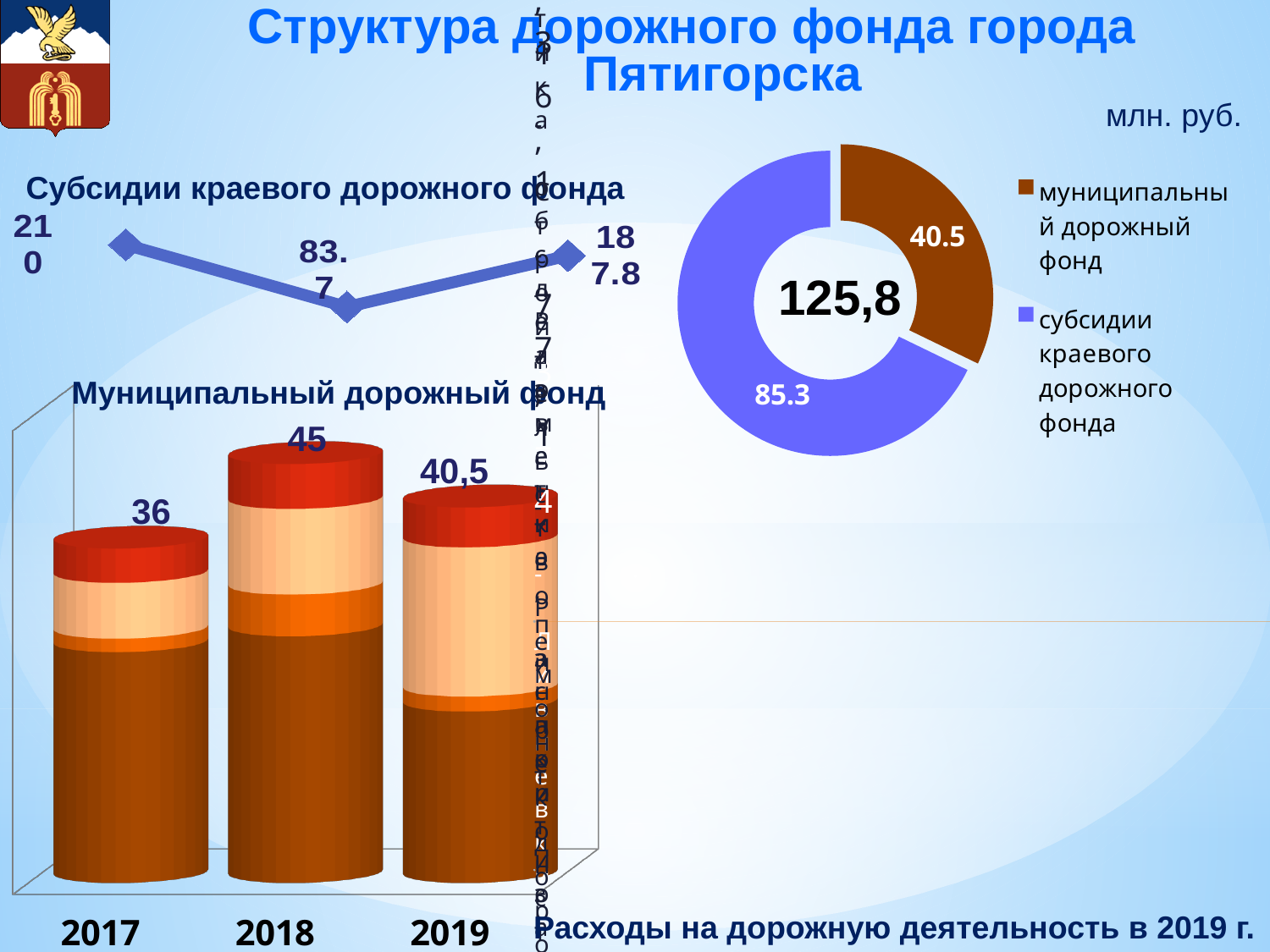
In the doughnut chart on the right, which category is larger: 'муниципальный дорожный фонд' or 'субсидии краевого дорожного фонда'? субсидии краевого дорожного фонда What total is printed in the centre of the doughnut chart on the right? 125,8 In the chart 'Муниципальный дорожный фонд', how many years are shown? 3 What kind of chart is 'Муниципальный дорожный фонд'? bar chart In the chart 'Муниципальный дорожный фонд', which year has the lowest value? 2017 In the chart 'Муниципальный дорожный фонд', what is the value for 2019? 40,5 How many entries does the legend of the doughnut chart on the right list? 2 In the doughnut chart on the right, what is the value for 'муниципальный дорожный фонд'? 40.5 In the chart 'Муниципальный дорожный фонд', which year has the highest value? 2018 In the doughnut chart on the right, what is the value for 'субсидии краевого дорожного фонда'? 85.3 In the chart 'Муниципальный дорожный фонд', what is the difference between the values for 2018 and 2017? 9 In the chart 'Муниципальный дорожный фонд', what is the value for 2018? 45